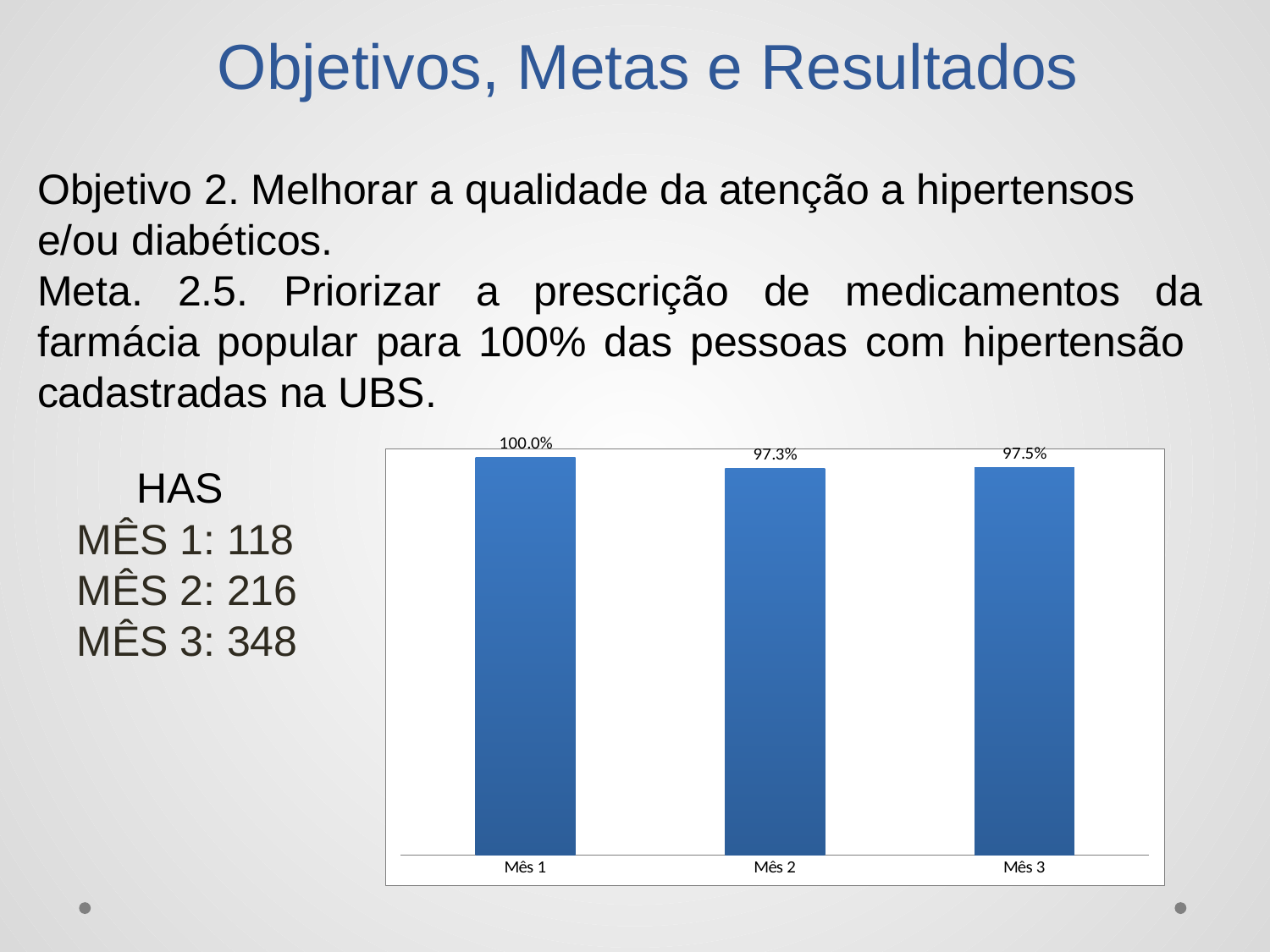
What is the difference between the values for Mês 3 and Mês 2? 0.2 percentage points How many bars are plotted in the chart? 3 Which month has the highest value in the bar chart? Mês 1 Does the value fall or rise from Mês 1 to Mês 2? Falls What is the value shown for Mês 1 in the bar chart? 100.0% What type of chart is shown on the slide? Bar chart What is the difference between the values for Mês 1 and Mês 2? 2.7 percentage points Which is larger according to the data labels, the value for Mês 2 or the value for Mês 3? Mês 3 What is the value shown for Mês 2 in the bar chart? 97.3% What is the value shown for Mês 3 in the bar chart? 97.5% What is the difference between the values for Mês 1 and Mês 3? 2.5 percentage points Which is larger, the value for Mês 1 or the value for Mês 2? Mês 1